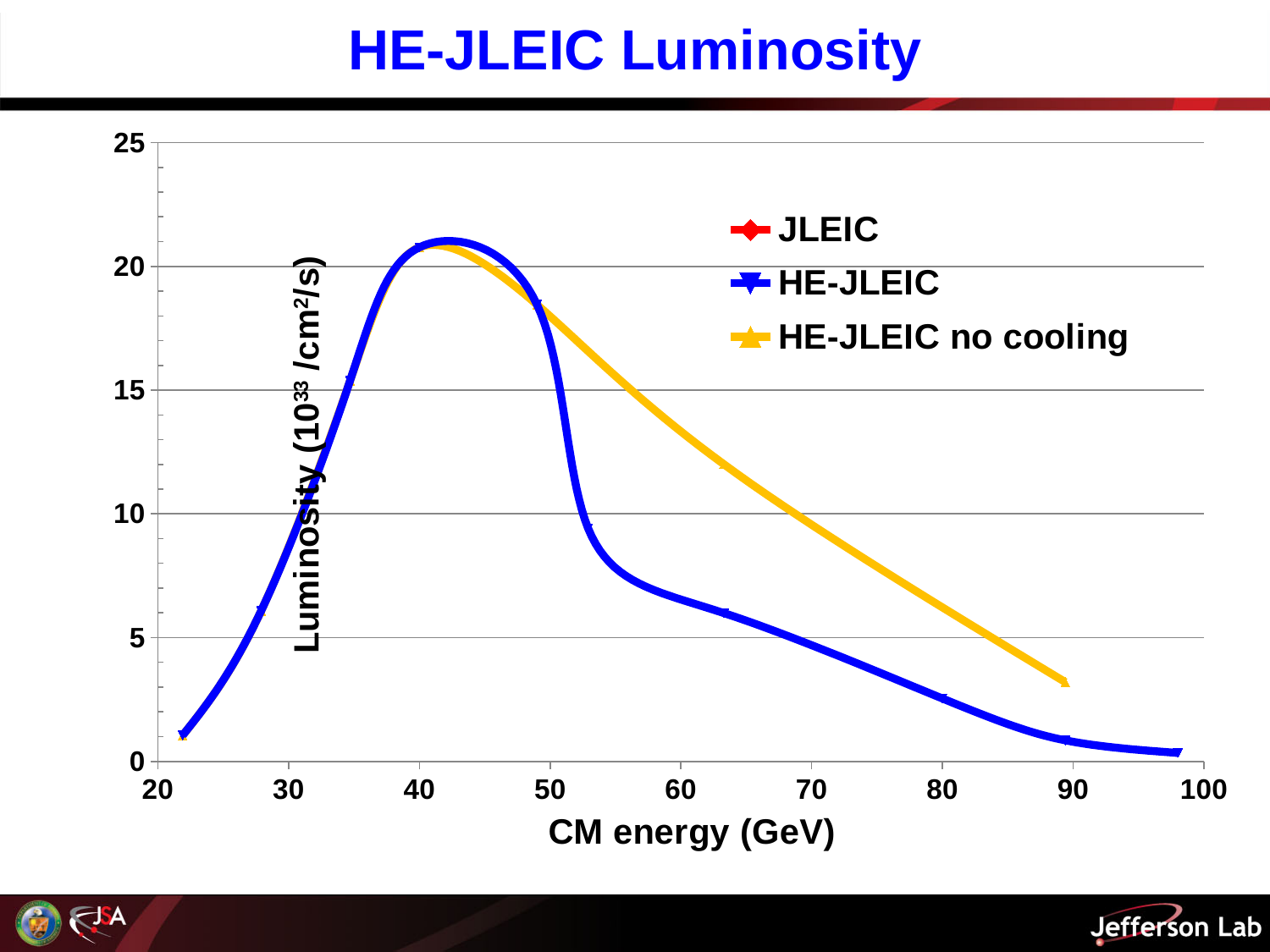
Between 50 GeV and 100 GeV, does the HE-JLEIC luminosity rise or fall as CM energy increases? fall What is the title of the chart? HE-JLEIC Luminosity Is the HE-JLEIC luminosity at 80 GeV greater or less than 5? less What is the label of the x axis? CM energy (GeV) Is the HE-JLEIC no cooling luminosity at 60 GeV greater or less than 10? greater At 70 GeV, which series has the higher luminosity, HE-JLEIC or HE-JLEIC no cooling? HE-JLEIC no cooling Is the HE-JLEIC no cooling luminosity at 80 GeV greater or less than 5? greater How many series does the legend list? 3 What kind of chart is shown on the slide? line chart